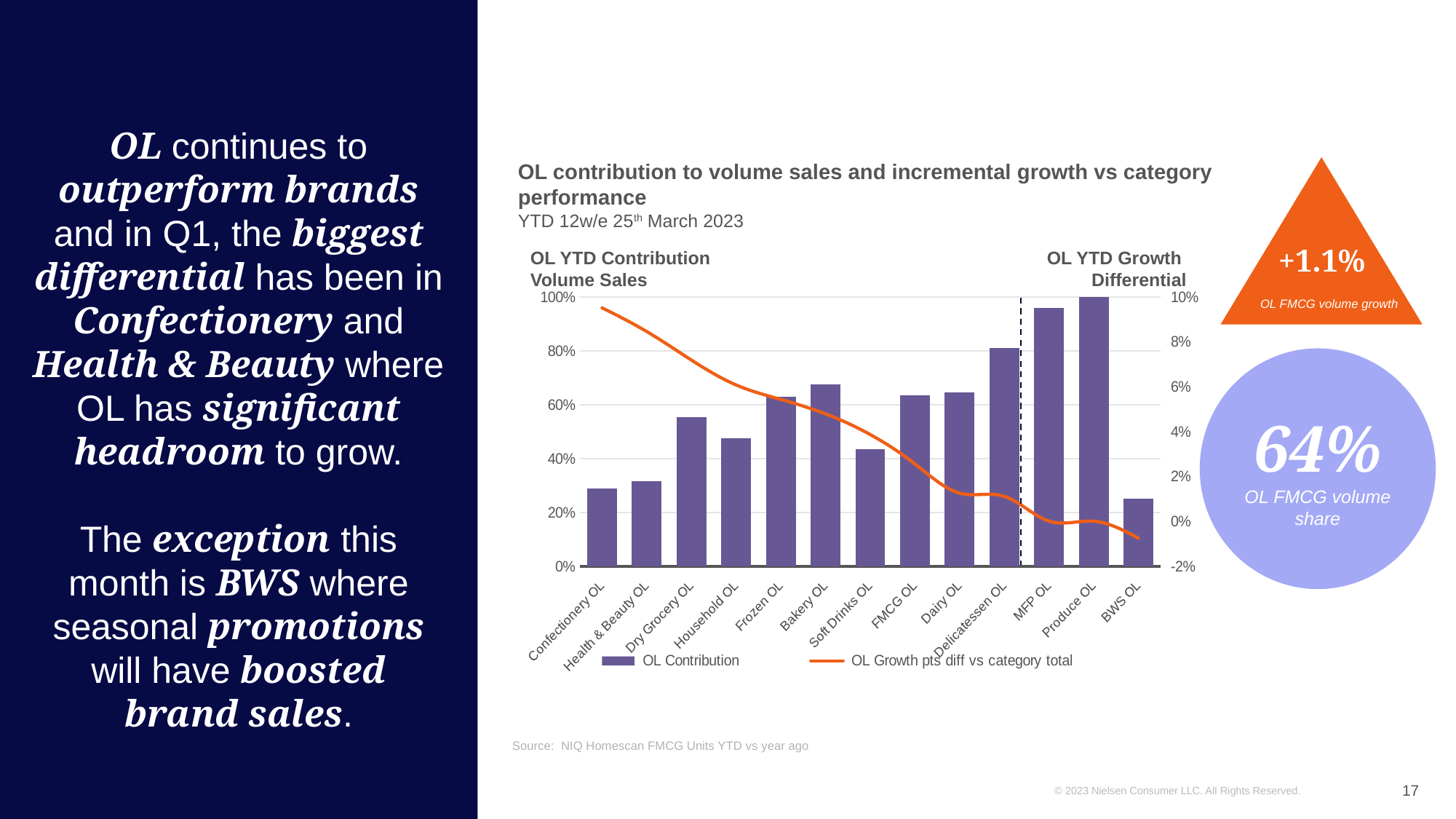
Is the OL Growth pts diff vs category total for Confectionery OL greater or less than 8%? greater What type of chart is shown on the slide? A combined bar and line chart Does the OL Growth pts diff vs category total line generally rise or fall from left to right across the categories? Fall Which category has the highest OL Contribution bar? Produce OL Is the OL Contribution for Delicatessen OL greater or less than 60%? greater How many categories are shown along the x axis of the chart? 13 Is the OL Growth pts diff vs category total for BWS OL greater or less than 0%? less How many series does the chart legend list? 2 Which has the larger OL Contribution, Dry Grocery OL or Household OL? Dry Grocery OL What is the title of the chart? OL contribution to volume sales and incremental growth vs category performance